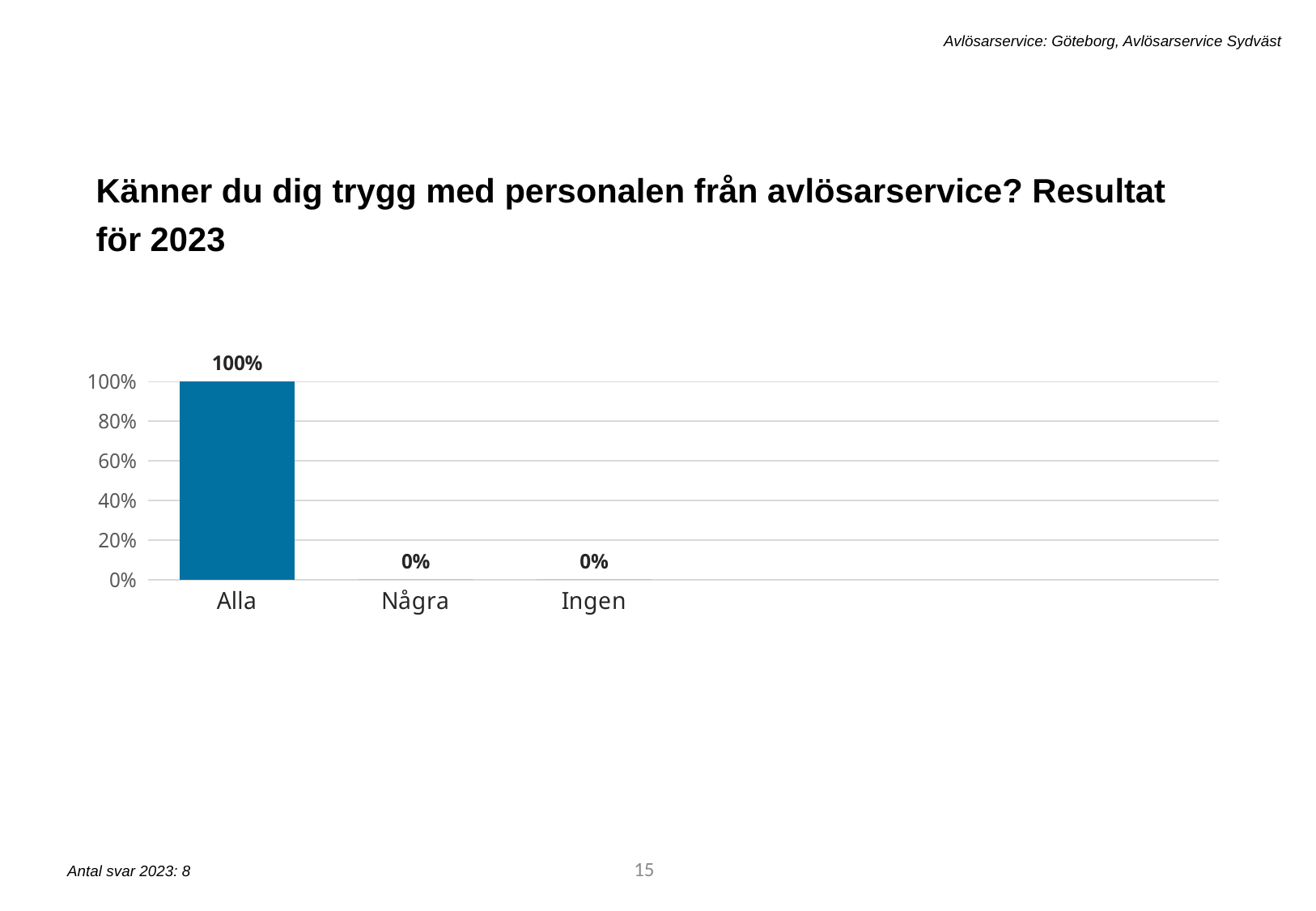
Which is larger, the value for Alla or the value for Ingen? Alla What is the highest value shown on the y axis? 100% What is the value for Några? 0% What is the value for Ingen? 0% What kind of chart is shown on the slide? bar chart What is the value for Alla? 100% Which category has the highest value? Alla How many categories are shown on the x axis? 3 What is the title of the chart? Känner du dig trygg med personalen från avlösarservice? Resultat för 2023 What is the difference between the values for Alla and Några? 100% Is the value for Alla greater or less than 80%? greater How many categories have a value of 0%? 2